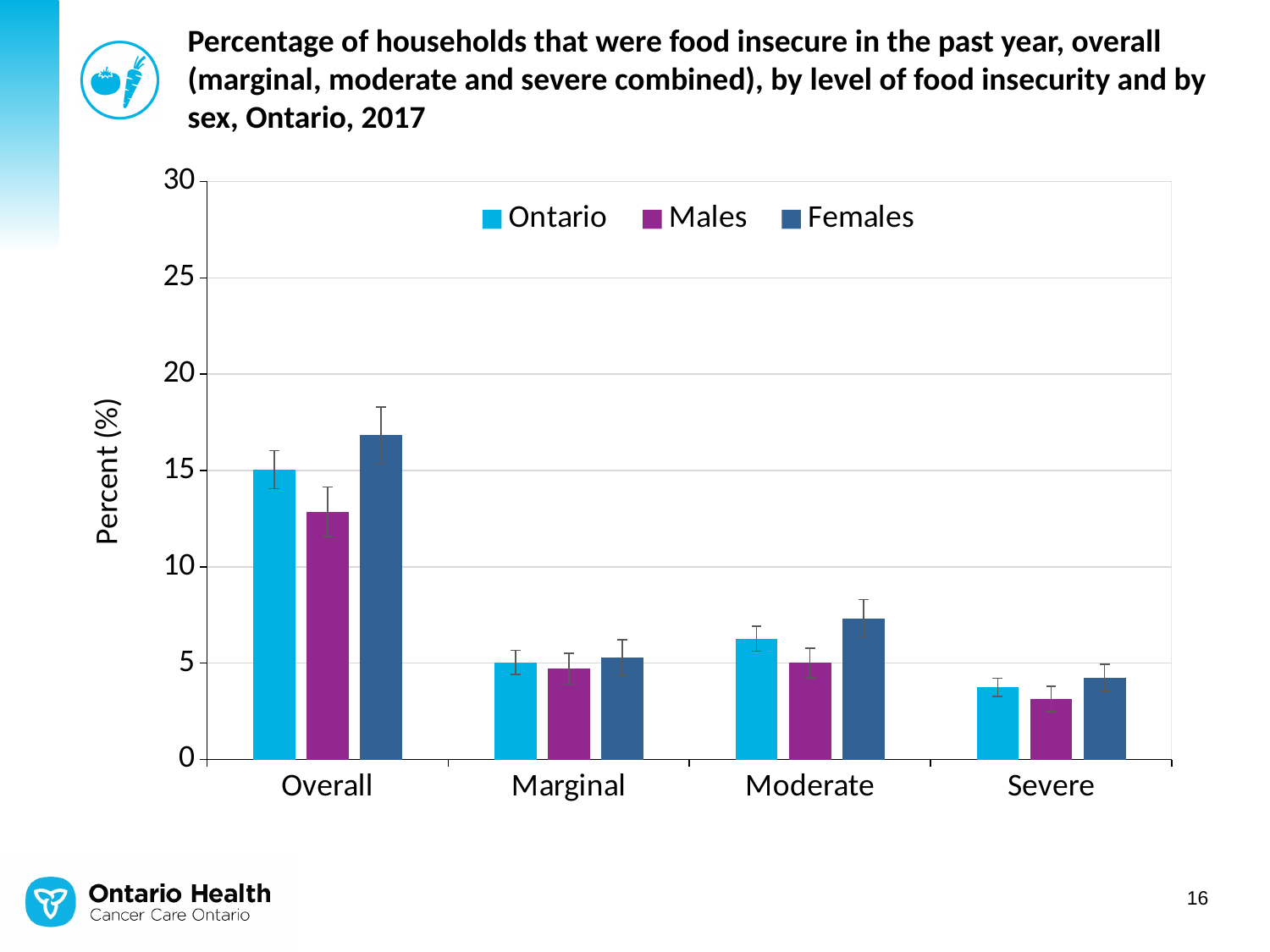
For the Females series, which category has the highest bar? Overall What is the label on the y axis? Percent (%) For the Ontario series, which category has the lowest bar? Severe Which series has the highest bar in the Overall category? Females What kind of chart is shown on the slide? bar chart Is the value for Females in the Overall category greater or less than 15? greater How many categories are shown on the x axis? 4 How many series does the legend list? 3 Is the value for Males in the Overall category greater or less than 15? less Is the value for Females in the Moderate category greater or less than 5? greater In the Moderate category, which is larger: the Males bar or the Females bar? Females Which series has the lowest bar in the Overall category? Males